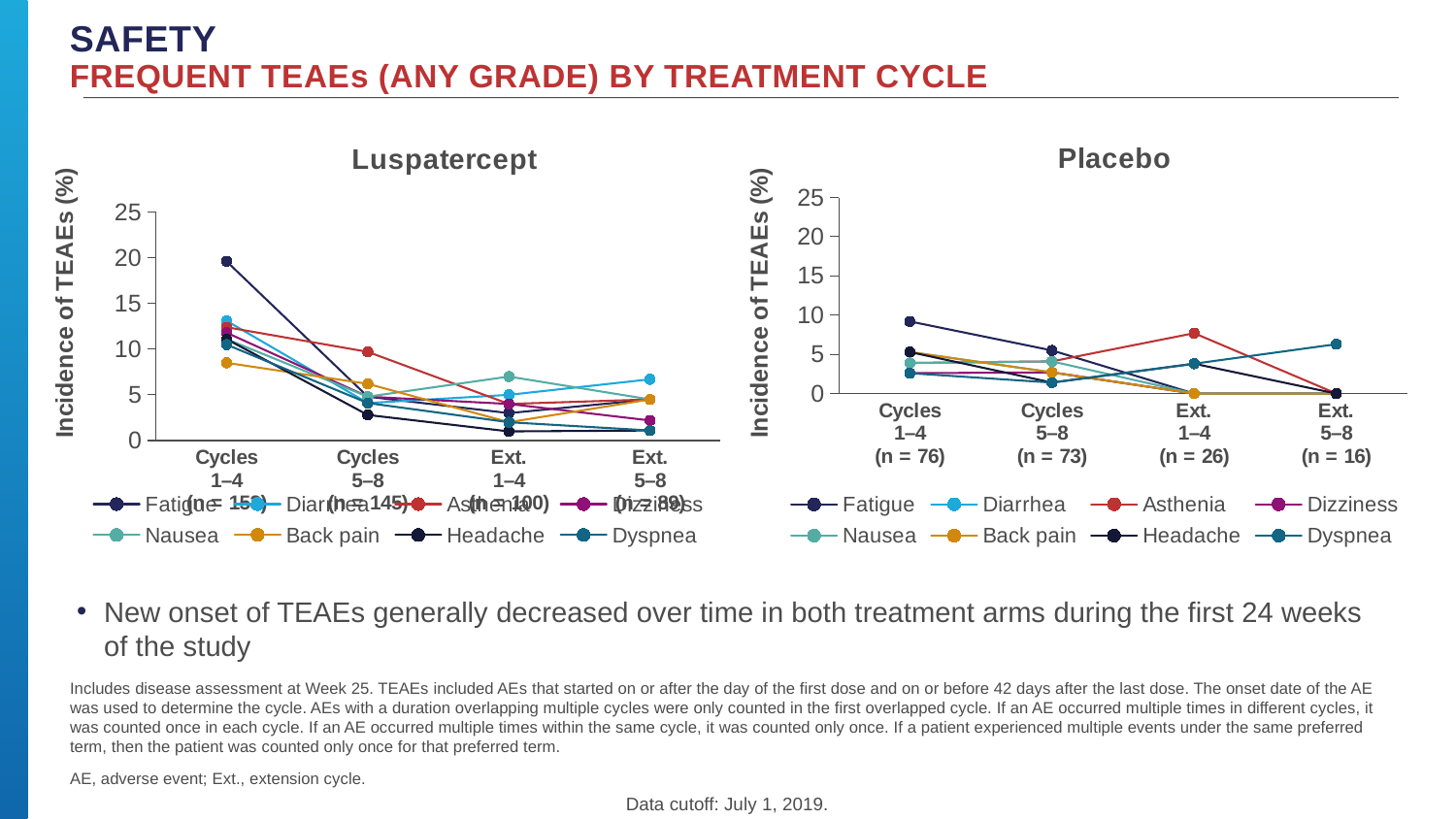
What is the y-axis label of the Placebo chart? Incidence of TEAEs (%) In the Luspatercept chart, is the value for Fatigue at Cycles 1–4 greater or less than 15? greater What kind of chart is the Luspatercept chart? Line chart In the Luspatercept chart, which series has the highest value at Cycles 1–4? Fatigue In the Luspatercept chart, does the Fatigue line rise or fall from Cycles 1–4 to Ext. 5–8? Fall In the Placebo chart, which series has the highest value at Ext. 1–4? Asthenia In the Placebo chart, does the Dyspnea line rise or fall from Ext. 1–4 to Ext. 5–8? Rise How many series does the legend of the Placebo chart list? 8 How many treatment cycle categories are shown on the x axis of the Luspatercept chart? 4 In the Placebo chart, is the value for Asthenia at Ext. 1–4 greater or less than 5? greater In the Luspatercept chart, which is larger at Cycles 5–8: Asthenia or Headache? Asthenia In the Luspatercept chart, is the value for Asthenia at Cycles 5–8 greater or less than 5? greater